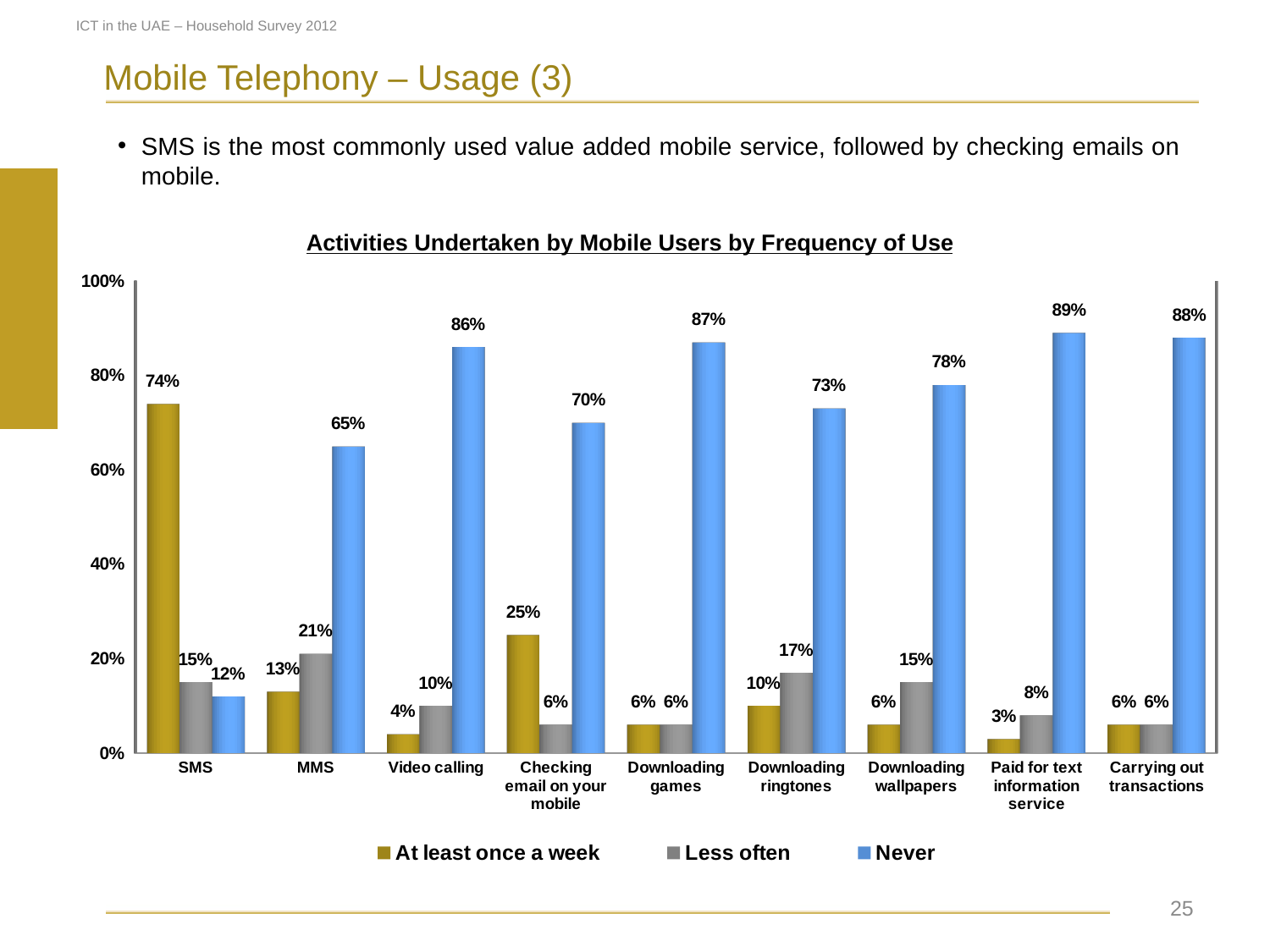
What kind of chart is shown on the slide? Bar chart What percentage of mobile users use SMS at least once a week? 74% Which is larger: the 'Less often' value for MMS or the 'Less often' value for Downloading ringtones? MMS What is the difference between the 'Never' values for MMS and Checking email on your mobile? 5% What is the title of the chart? Activities Undertaken by Mobile Users by Frequency of Use Is the 'Never' value for Downloading wallpapers greater or less than 60%? greater What percentage of mobile users check email on their mobile at least once a week? 25% How many activities are shown on the x axis of the chart? 9 Which activity has the highest 'Never' percentage? Paid for text information service Which activity has the lowest 'At least once a week' percentage? Paid for text information service What is the 'Never' value for Video calling? 86% How many series does the legend list? 3